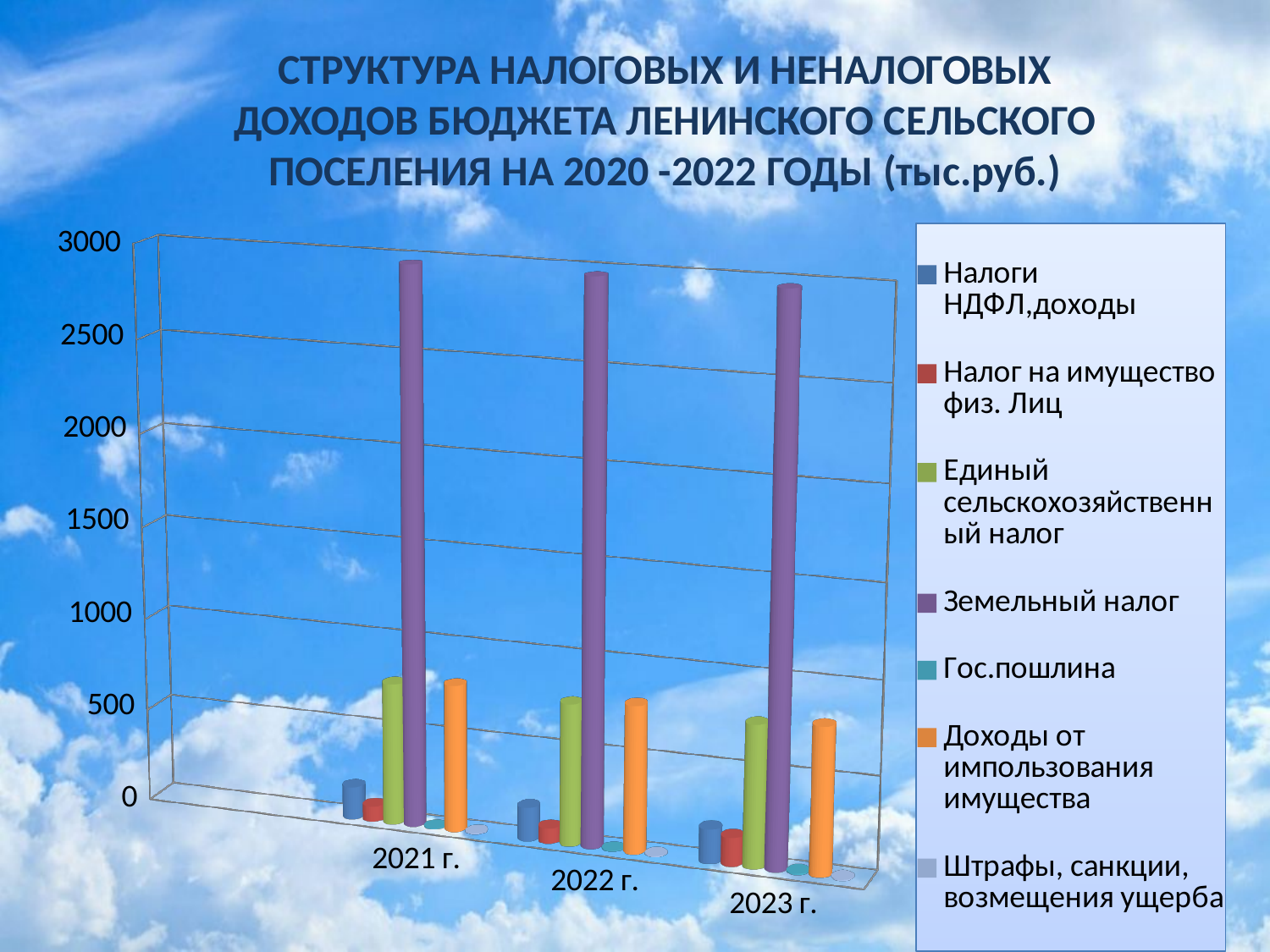
Is the value for Земельный налог in 2021 г. greater or less than 2500? greater How many year categories are shown on the x axis? 3 In 2023 г., which is larger: Единый сельскохозяйственный налог or Налог на имущество физ. Лиц? Единый сельскохозяйственный налог Is the value for Доходы от импользования имущества in 2021 г. greater or less than 1000? less Is the value for Налоги НДФЛ,доходы in 2021 г. greater or less than 500? less What kind of chart is shown on the slide? Bar chart Which series has the highest value in 2023 г.? Земельный налог Which series has the highest value in 2021 г.? Земельный налог What colour represents Земельный налог in the legend? Purple How many series does the legend list? 7 In 2022 г., which is larger: Земельный налог or Доходы от импользования имущества? Земельный налог